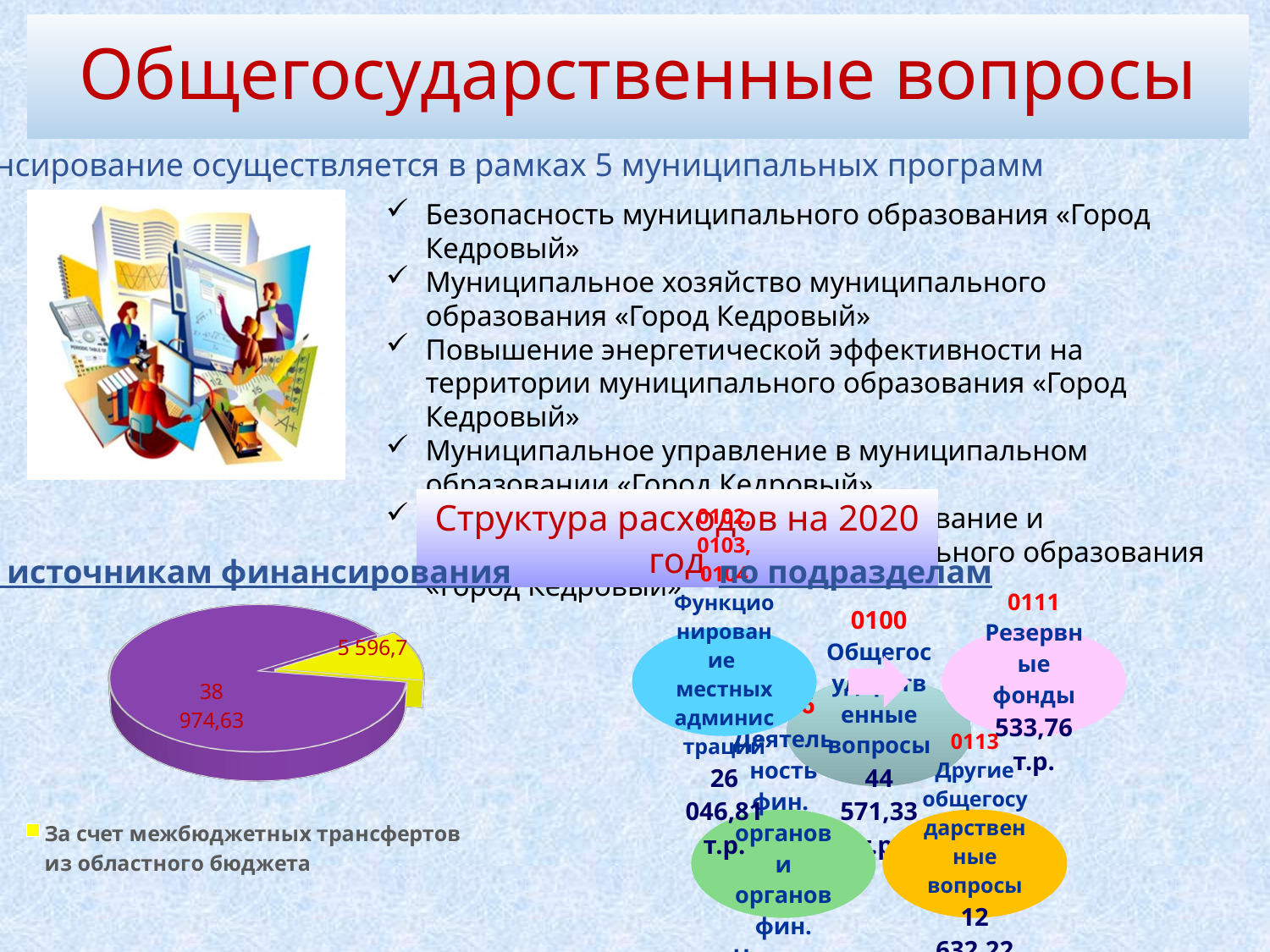
In the pie chart "по источникам финансирования", what is the difference between the purple slice value (38 974,63) and the yellow slice value (5 596,7)? 33 377,93 What heading appears above the pie chart on the left of the slide? по источникам финансирования In the pie chart "по источникам финансирования", what is the sum of the two slice values shown? 44 571,33 In the pie chart "по источникам финансирования", what value is shown for "За счет межбюджетных трансфертов из областного бюджета"? 5 596,7 In the pie chart "по источникам финансирования", what value is printed on the smallest slice? 5 596,7 What kind of chart is shown under the heading "по источникам финансирования"? pie chart In the pie chart "по источникам финансирования", what colour is the slice for "За счет межбюджетных трансфертов из областного бюджета"? yellow How many slices does the pie chart "по источникам финансирования" have? 2 In the pie chart "по источникам финансирования", which slice is larger: the purple slice or the yellow slice? the purple slice In the pie chart "по источникам финансирования", what value is printed on the largest slice? 38 974,63